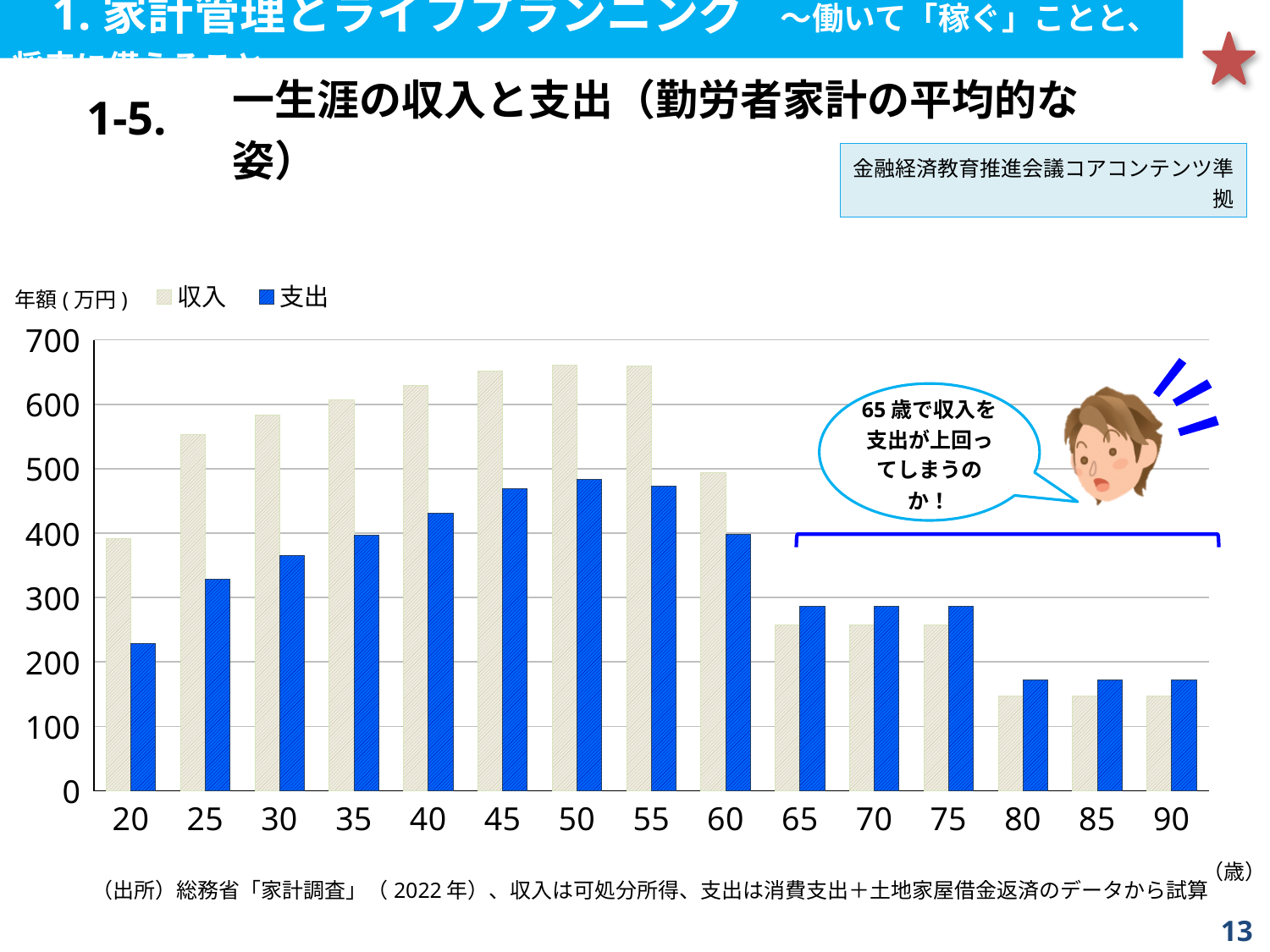
Is the 収入 value at age 80 greater or less than 200? less Is the 支出 value at age 45 greater or less than 400? greater Is the 収入 value at age 50 greater or less than 600? greater How many series does the legend list? 2 What unit label is shown for the y axis? 年額(万円) At age 65, which is larger, 収入 or 支出? 支出 At age 40, which is larger, 収入 or 支出? 収入 What kind of chart is shown on the slide? bar chart Do the 収入 values rise or fall from age 20 to age 50? rise How many age categories are shown on the x axis? 15